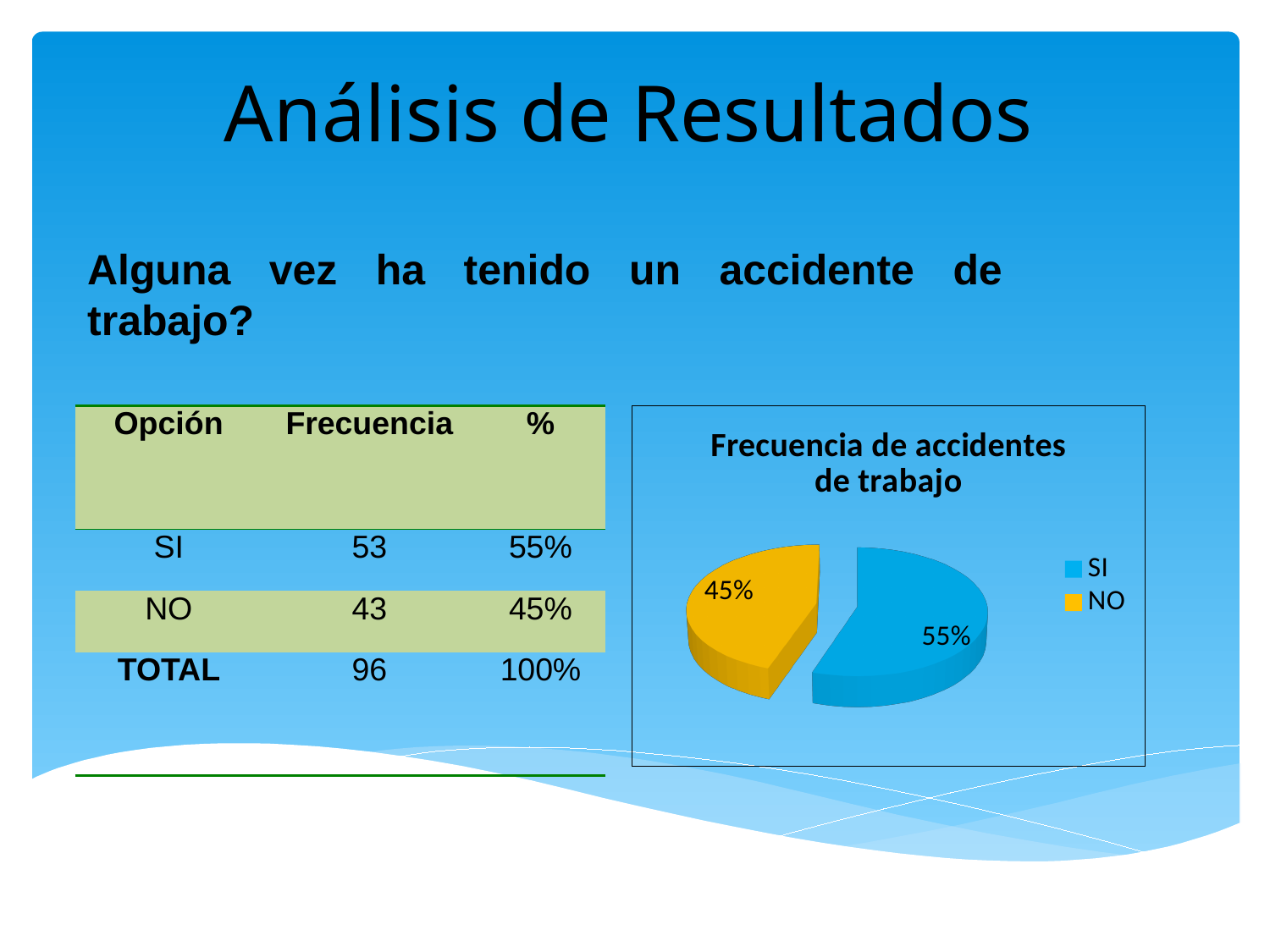
What percentage does the NO slice show in the pie chart? 45% What percentage does the SI slice show in the pie chart? 55% How many entries does the legend list? 2 Which is larger in the pie chart, SI or NO? SI What is the title of the chart? Frecuencia de accidentes de trabajo What is the difference in percentage points between the SI and NO slices? 10% What kind of chart is shown on the slide? pie chart Is the value for NO greater or less than 50%? less Which slice of the pie chart is the largest? SI How many slices does the pie chart have? 2 What colour is the SI slice in the pie chart? blue Which slice of the pie chart is the smallest? NO